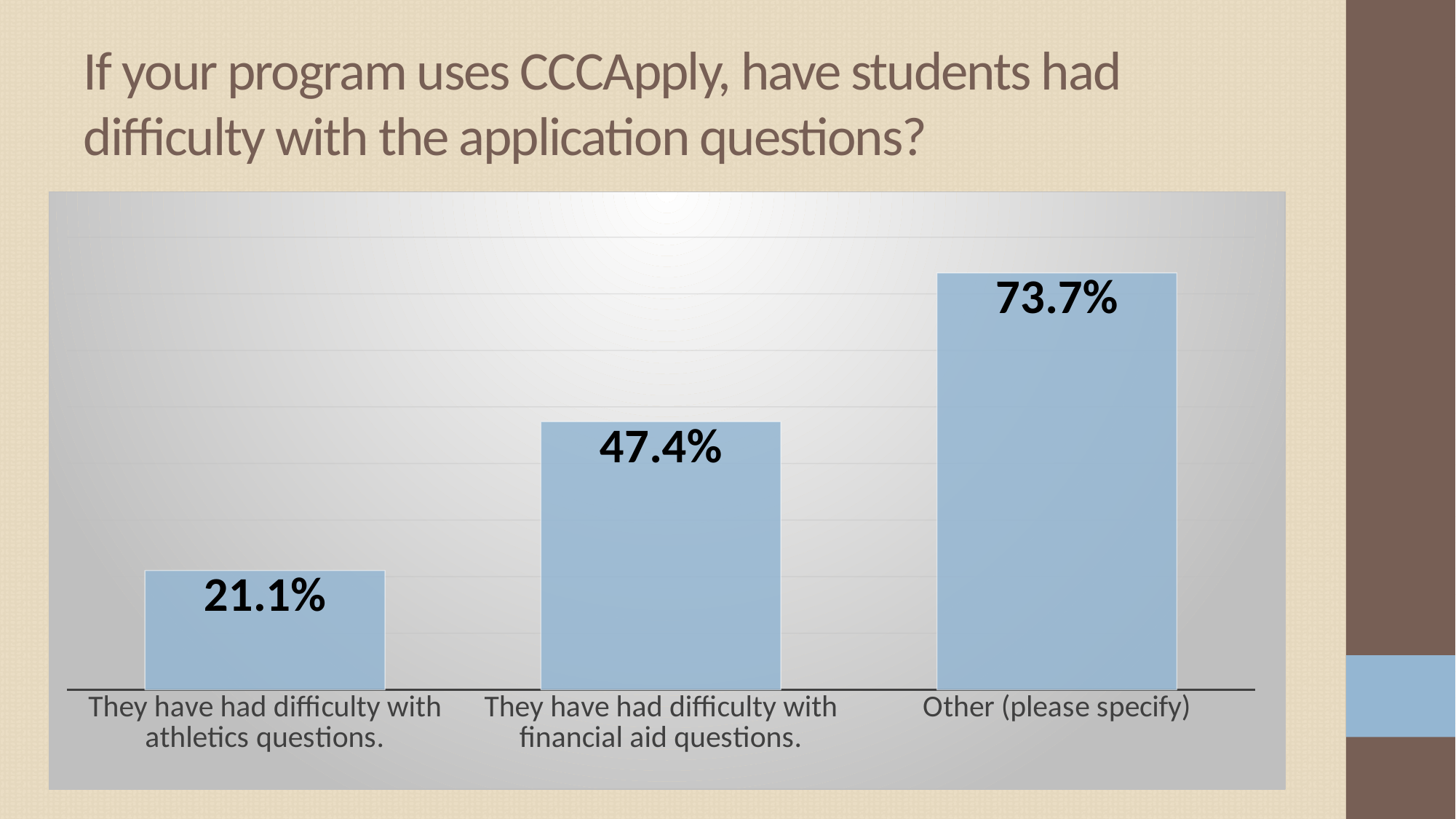
Which category has the lowest value? They have had difficulty with athletics questions. What is the value for the 'Other (please specify)' category? 73.7% Which category has the highest value? Other (please specify) What kind of chart is shown on the slide? bar chart What is the difference between the 'Other (please specify)' value and the financial aid questions value? 26.3% What is the difference between the financial aid questions value and the athletics questions value? 26.3% What percentage of respondents said students have had difficulty with financial aid questions? 47.4% Which is larger: the value for financial aid questions or the value for athletics questions? financial aid questions How many categories are shown in the chart? 3 What is the title of the slide containing the chart? If your program uses CCCApply, have students had difficulty with the application questions? What percentage of respondents said students have had difficulty with athletics questions? 21.1% Do the values rise or fall from left to right across the categories? rise